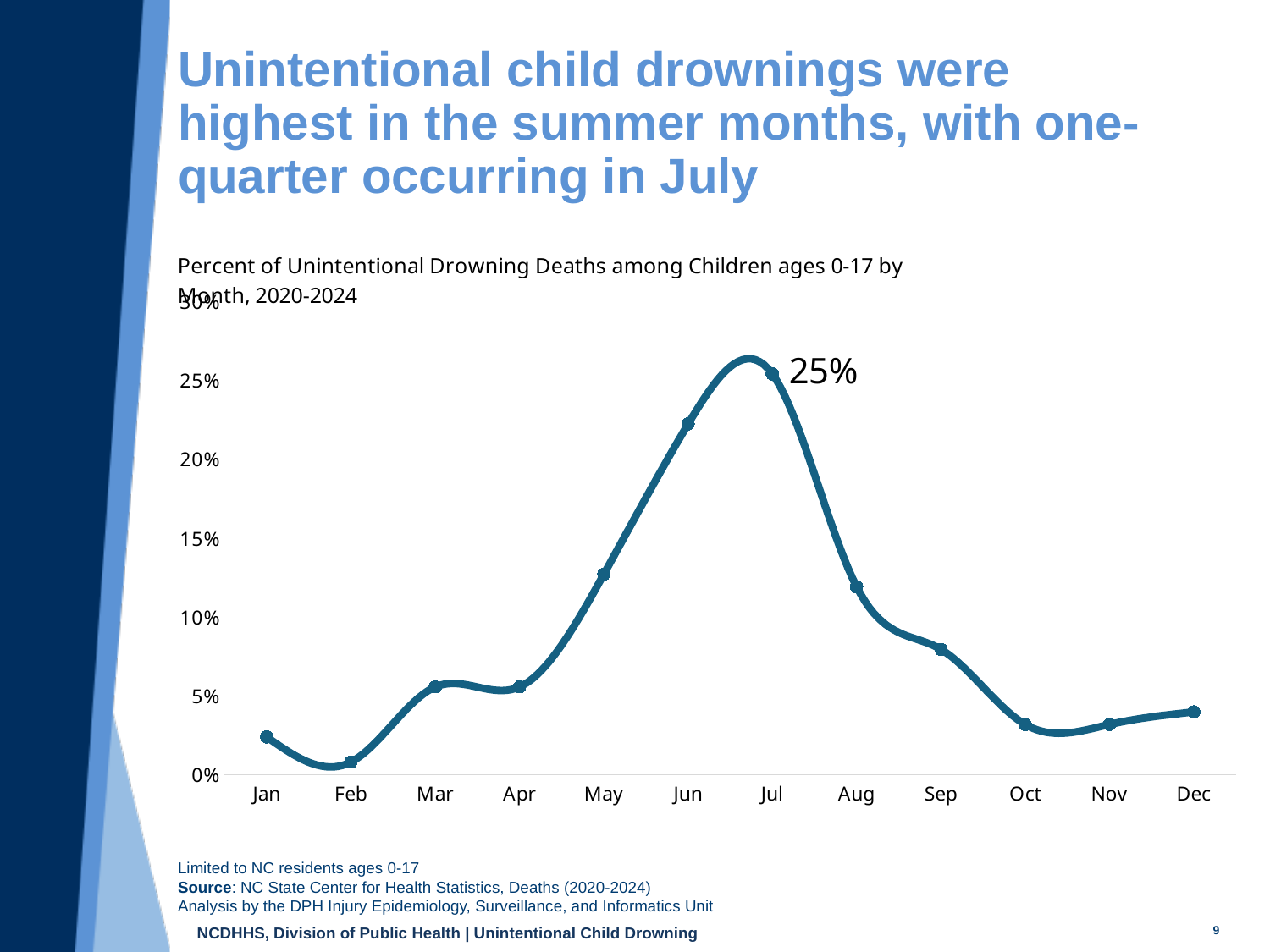
Is the value for Jun greater or less than 20%? greater Is the value for May greater or less than 10%? greater Do the values rise or fall from Jul to Oct? fall Is the value for Sep greater or less than 10%? less Which is larger, the value for Jun or the value for Aug? Jun Which month has the lowest value? Feb How many months are plotted on the x axis? 12 What is the title of the chart? Percent of Unintentional Drowning Deaths among Children ages 0-17 by Month, 2020-2024 What kind of chart is shown on the slide? Line chart Which month has the highest value? Jul What is the value for Jul? 25%